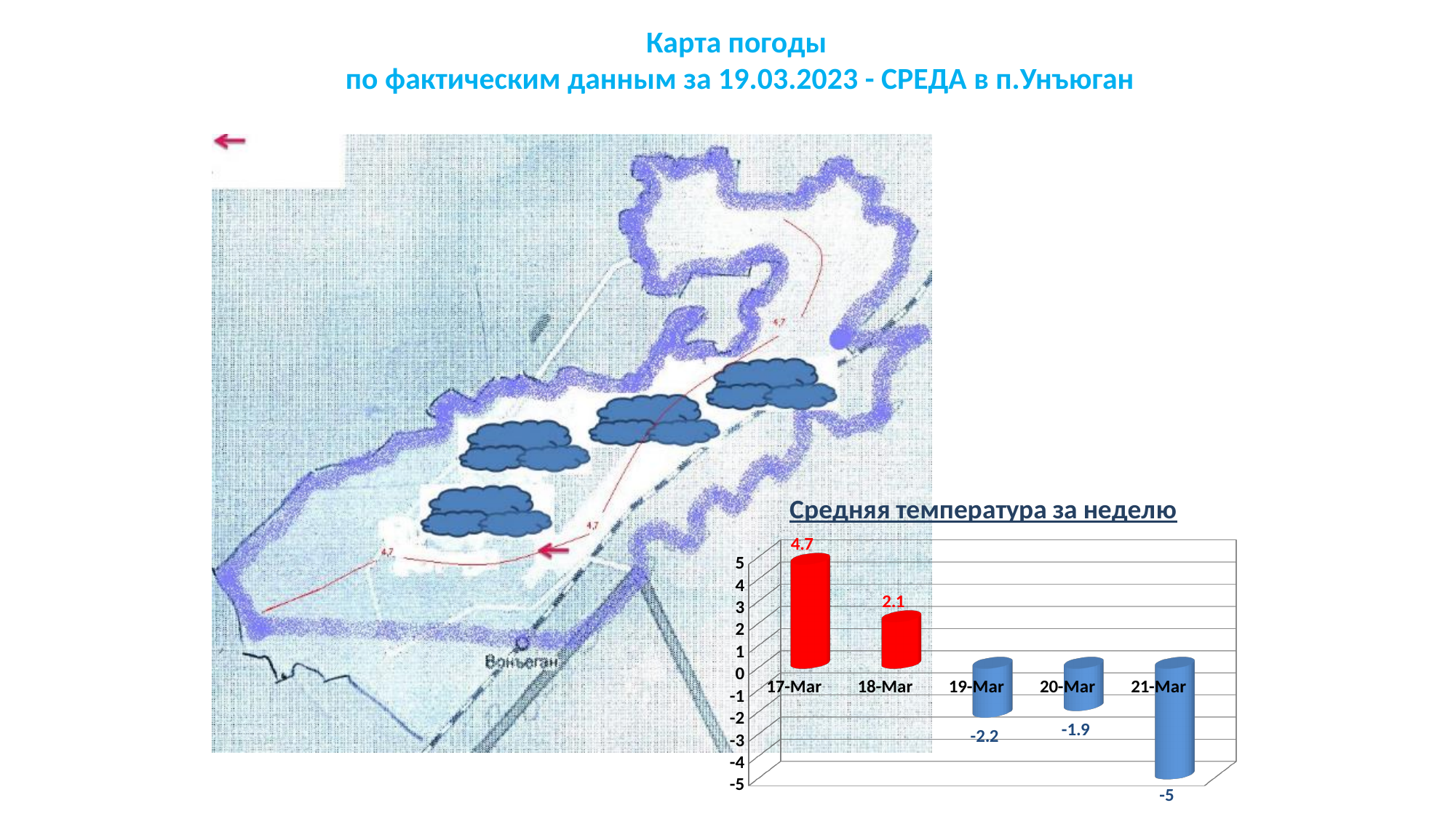
Which date has the highest average temperature in the chart? 17-Mar What is the value for 21-Mar in the chart? -5 What is the value for 19-Mar in the chart? -2.2 What is the average temperature shown for 17-Mar in the 'Средняя температура за неделю' chart? 4.7 Which is larger, the value for 19-Mar or the value for 20-Mar? 20-Mar How many dates are shown in the chart? 5 Which date has the lowest average temperature in the chart? 21-Mar What is the value for 18-Mar in the chart? 2.1 What kind of chart is 'Средняя температура за неделю'? Bar chart What is the value for 20-Mar in the chart? -1.9 What is the title of the chart on the slide? Средняя температура за неделю What is the difference between the values for 17-Mar and 18-Mar? 2.6